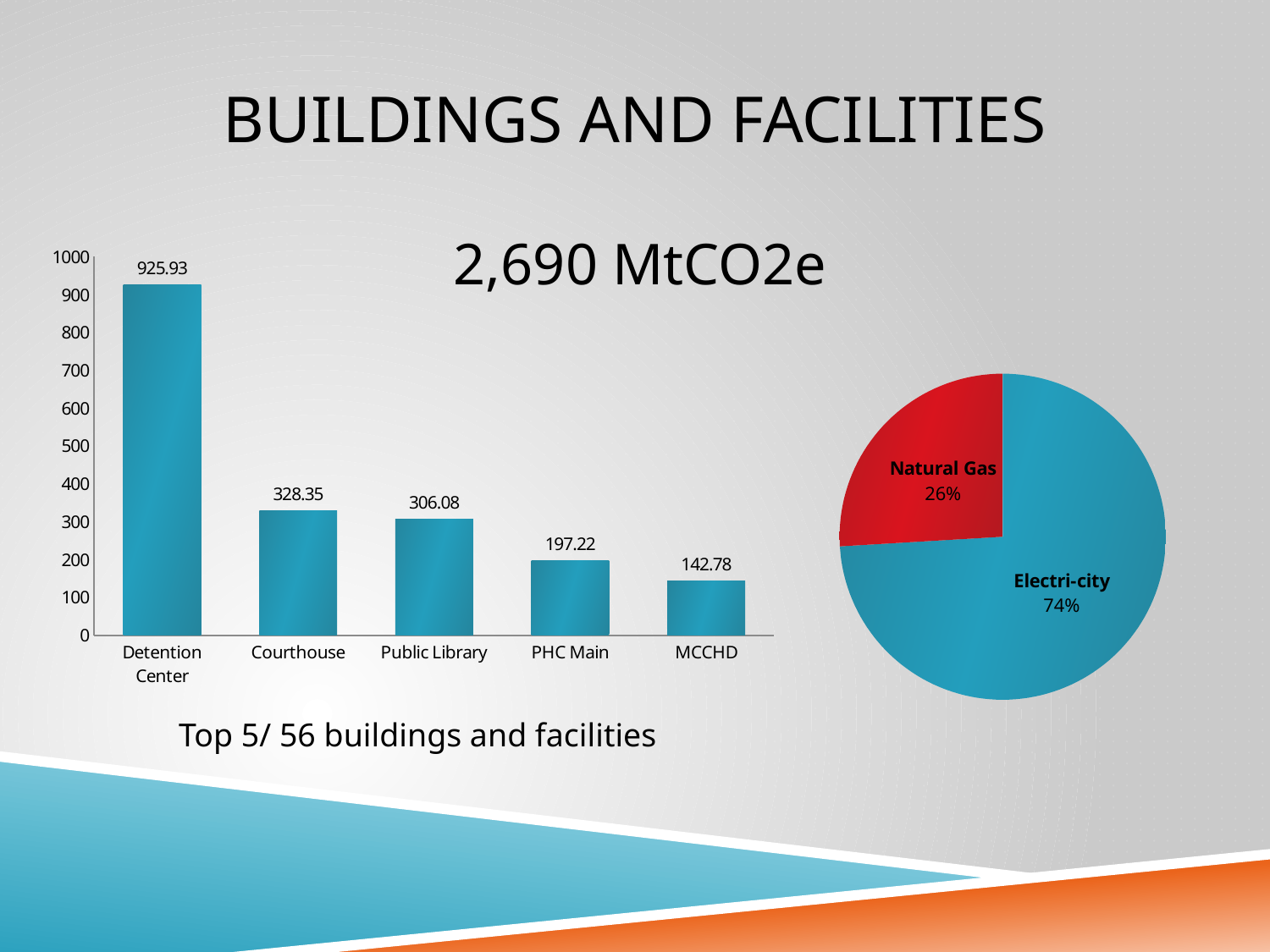
In the bar chart on the left, which category has the lowest value? MCCHD What kind of chart is the chart on the left of the slide? Bar chart In the bar chart on the left, what is the value for Detention Center? 925.93 In the pie chart on the right, what share does Natural Gas have? 26% In the bar chart on the left, which is larger, the value for PHC Main or the value for MCCHD? PHC Main In the bar chart on the left, what is the value for Courthouse? 328.35 In the bar chart on the left, which category has the highest value? Detention Center In the bar chart on the left, how many categories are shown? 5 In the bar chart on the left, what is the difference between the values for Courthouse and Public Library? 22.27 In the pie chart on the right, which slice is larger, Electri-city or Natural Gas? Electri-city In the bar chart on the left, do the values rise or fall from left to right along the x axis? Fall In the bar chart on the left, what is the value for PHC Main? 197.22